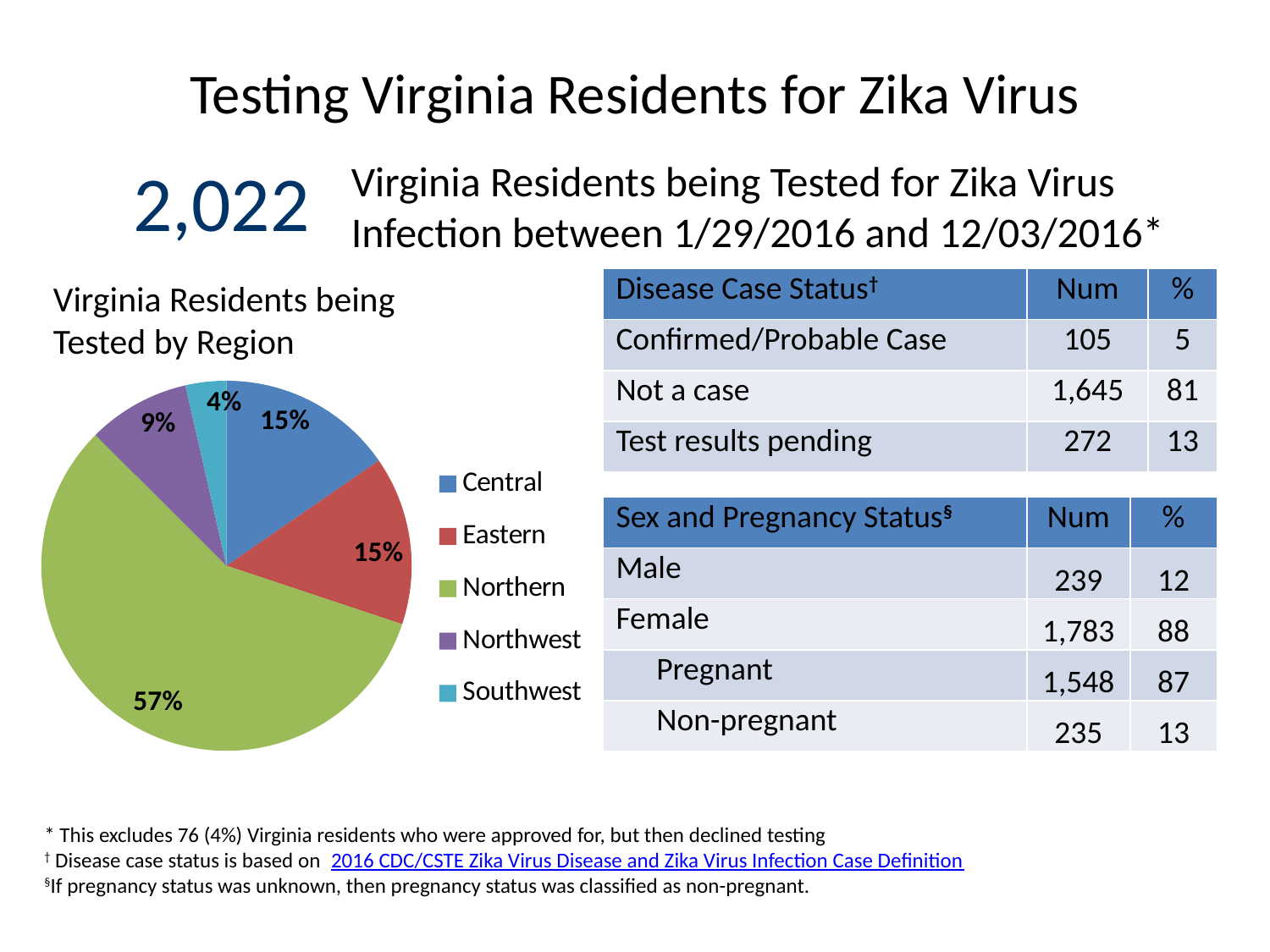
What type of chart is shown on the slide? pie chart Which region has the largest slice of the pie? Northern What is the value for Northwest in the pie chart? 9% Which is larger, the share for Northwest or the share for Southwest? Northwest Which region has the smallest slice of the pie? Southwest How many regions are shown in the pie chart? 5 What share of the pie does Northern represent? 57% What is the value for Southwest in the pie chart? 4% What is the value for Central in the pie chart? 15% What is the title of the chart? Virginia Residents being Tested by Region What is the difference between the Northern and Northwest shares? 48% Which region is shown in green in the pie chart? Northern